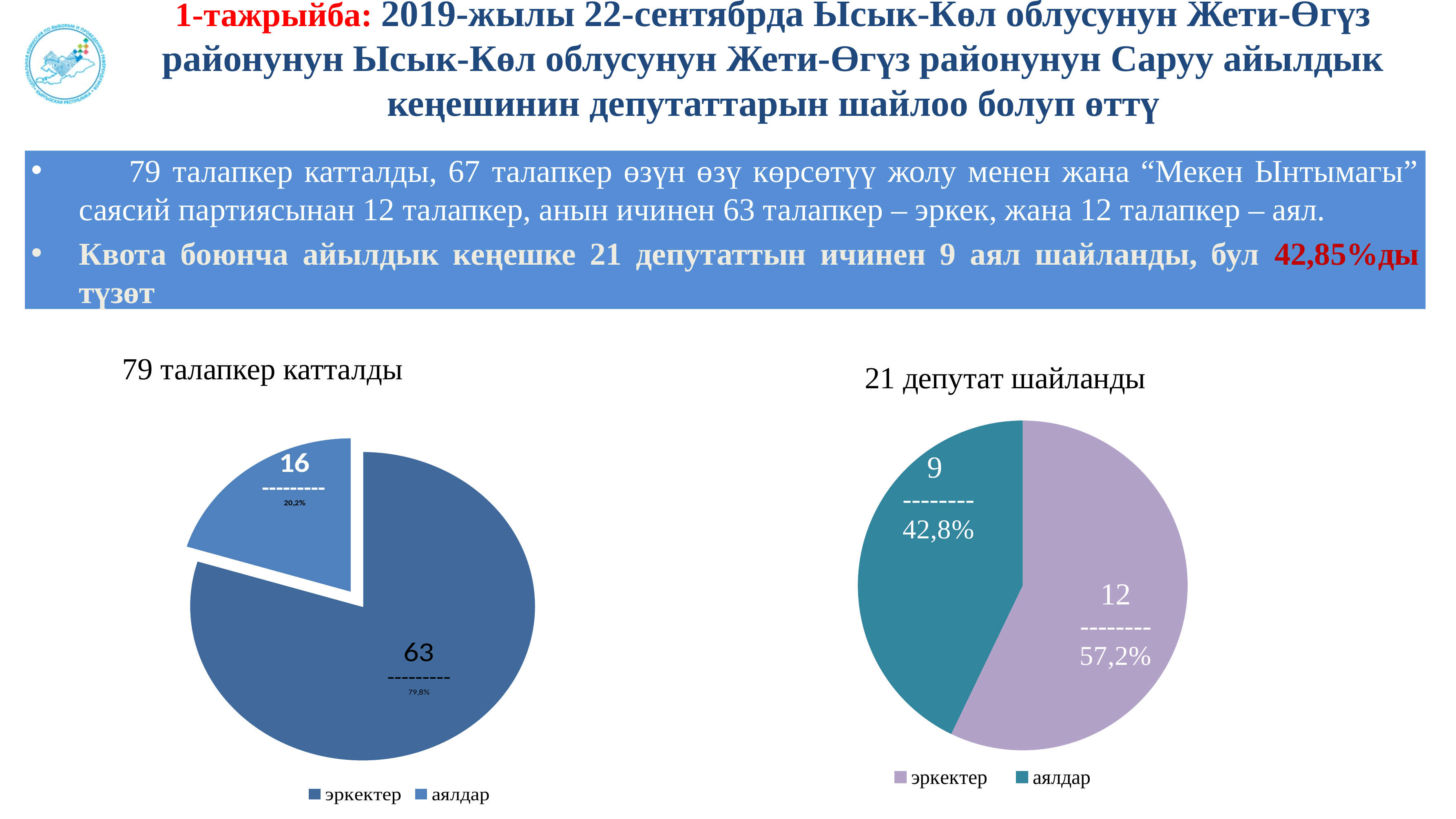
In the chart titled "79 талапкер катталды", what is the value for аялдар? 16 In the chart titled "21 депутат шайланды", what is the value for аялдар? 9 In the chart titled "21 депутат шайланды", what is the value for эркектер? 12 How many entries does the legend of the chart titled "21 депутат шайланды" list? 2 In the chart titled "79 талапкер катталды", what share of the pie does эркектер take? 79,8% In the chart titled "79 талапкер катталды", what share of the pie does аялдар take? 20,2% In the chart titled "21 депутат шайланды", what share of the pie does аялдар take? 42,8% In the chart titled "21 депутат шайланды", what is the difference between the values for эркектер and аялдар? 3 What kind of chart is the chart titled "79 талапкер катталды"? pie chart In the chart titled "79 талапкер катталды", what is the value for эркектер? 63 In the chart titled "79 талапкер катталды", what is the difference between the values for эркектер and аялдар? 47 In the chart titled "21 депутат шайланды", which category is the largest? эркектер